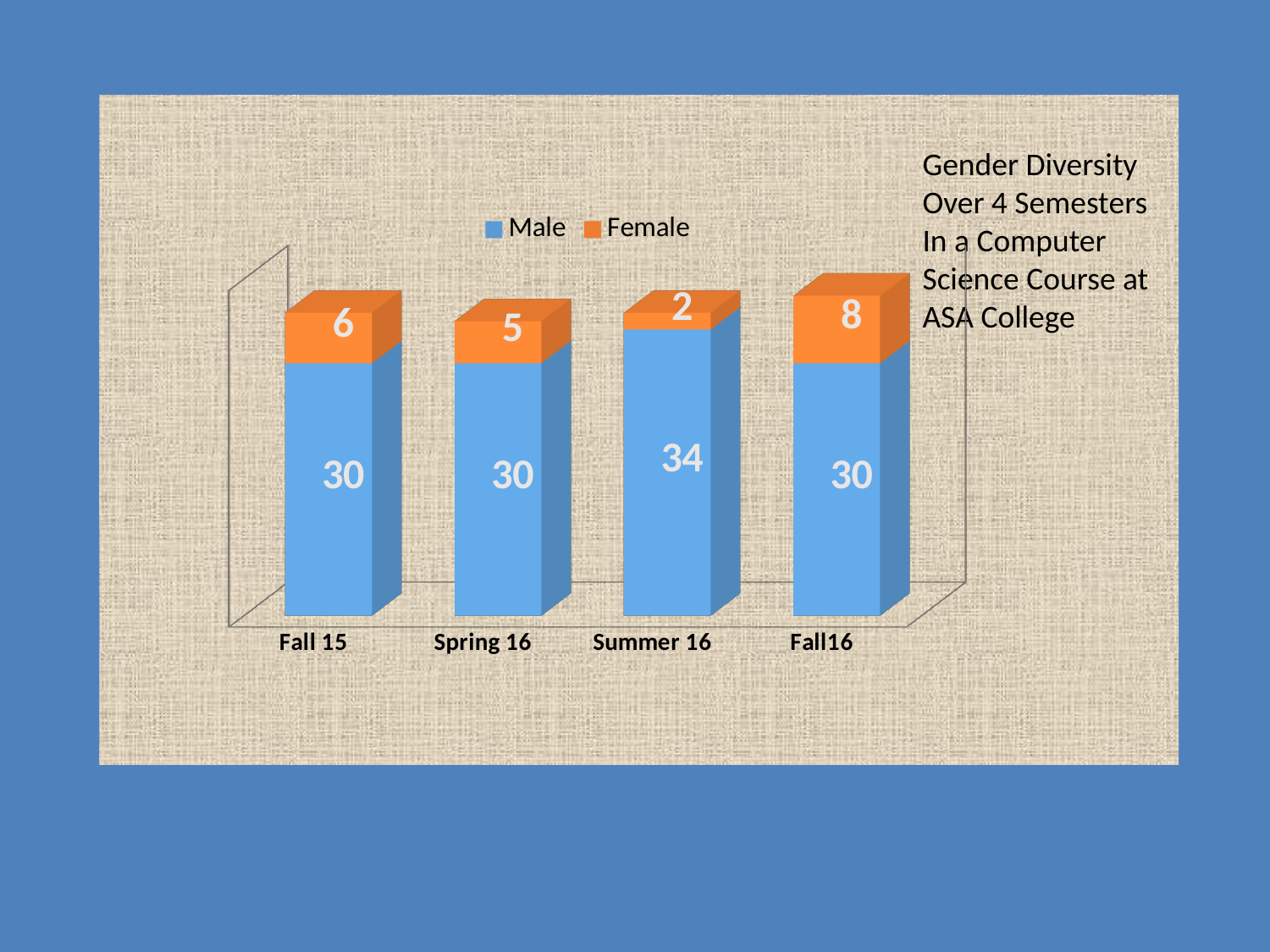
Is the Female value larger for Fall 15 or Spring 16? Fall 15 How many semesters are shown on the x axis? 4 Which semester has the lowest Female value? Summer 16 What is the total of the stacked bar for Fall16? 38 How many series does the legend list? 2 Which semester has the highest Female value? Fall16 Which semester has the highest Male value? Summer 16 What is the Female value for Fall16? 8 What is the Male value for Summer 16? 34 What is the total of the stacked bar for Summer 16? 36 What is the difference between the Female values for Fall16 and Summer 16? 6 What is the Female value for Spring 16? 5